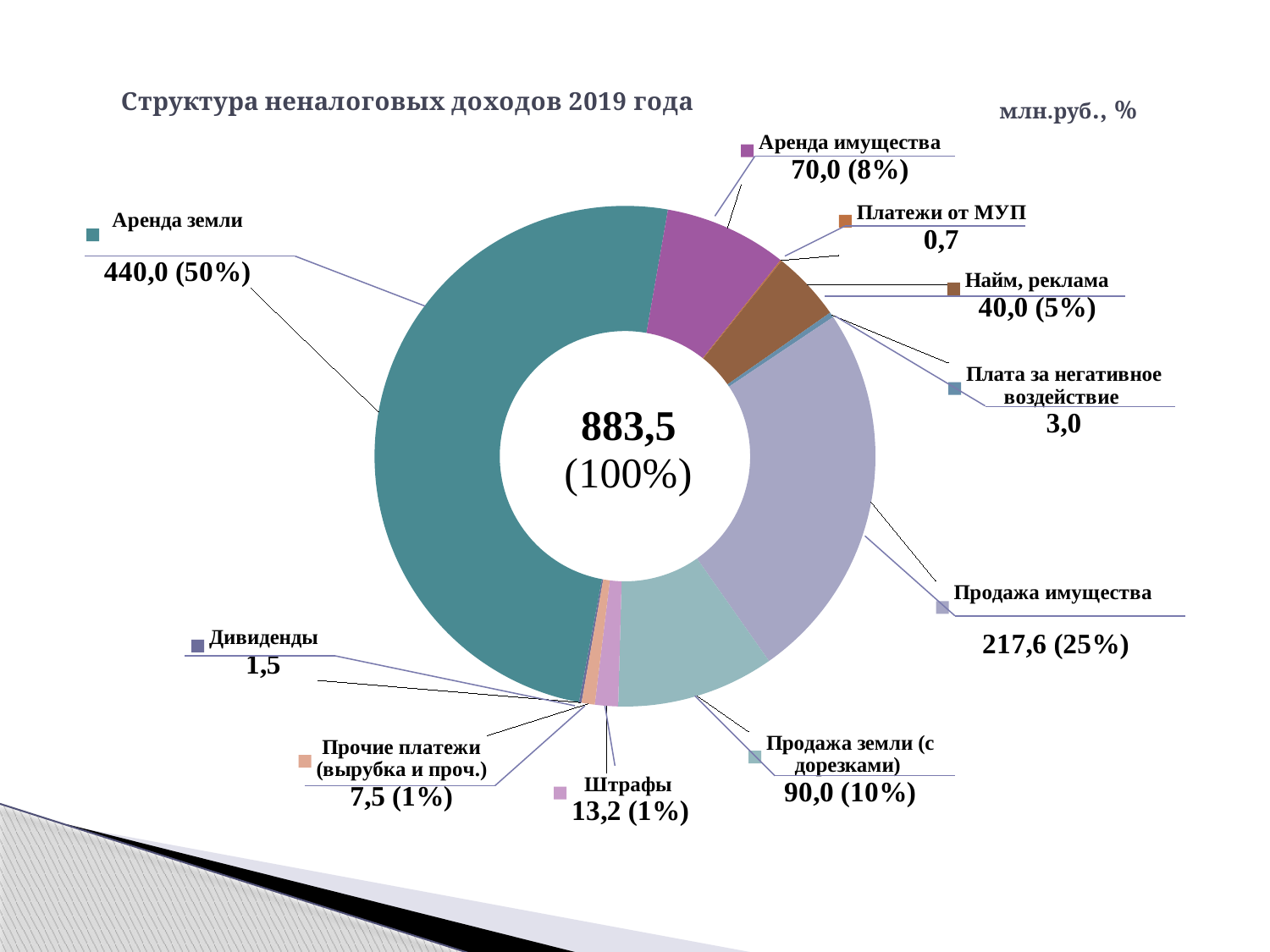
Which is larger: Аренда имущества or Найм, реклама? Аренда имущества Which category has the largest share of the chart? Аренда земли What is the title of the chart? Структура неналоговых доходов 2019 года What is the value shown for Платежи от МУП? 0,7 Which category has the smallest value on the chart? Платежи от МУП What is the total value shown in the centre of the chart? 883,5 (100%) How many categories are shown on the chart? 10 What share of the chart does Продажа земли (с дорезками) represent? 10% What is the value shown for Аренда земли? 440,0 (50%) What is the value shown for Продажа имущества? 217,6 (25%) What type of chart is shown on the slide? Doughnut (pie) chart What is the value shown for Штрафы? 13,2 (1%)